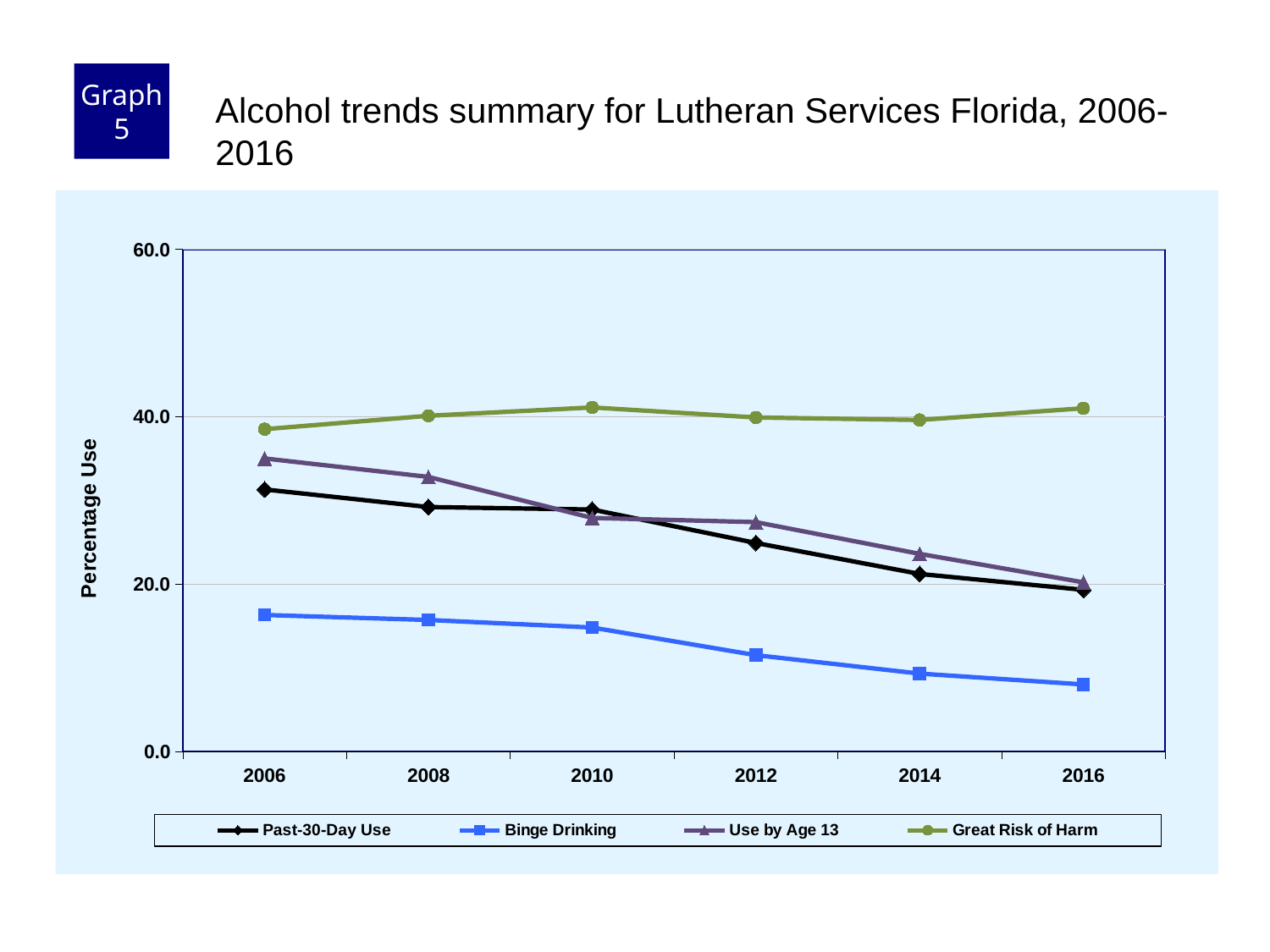
Which series has the lowest value in 2006? Binge Drinking How many years are plotted along the x axis? 6 What is the title of the chart? Alcohol trends summary for Lutheran Services Florida, 2006-2016 What is the label on the y axis? Percentage Use Which series has the highest value in 2016? Great Risk of Harm Is the value for Past-30-Day Use in 2006 greater or less than 20.0? greater Is the value for Binge Drinking in 2006 greater or less than 20.0? less How many series does the legend list? 4 In 2006, which is larger: Use by Age 13 or Past-30-Day Use? Use by Age 13 Does the Binge Drinking series rise or fall from 2006 to 2016? fall What kind of chart is shown on the slide? line chart Is the value for Great Risk of Harm in 2006 greater or less than 40.0? less